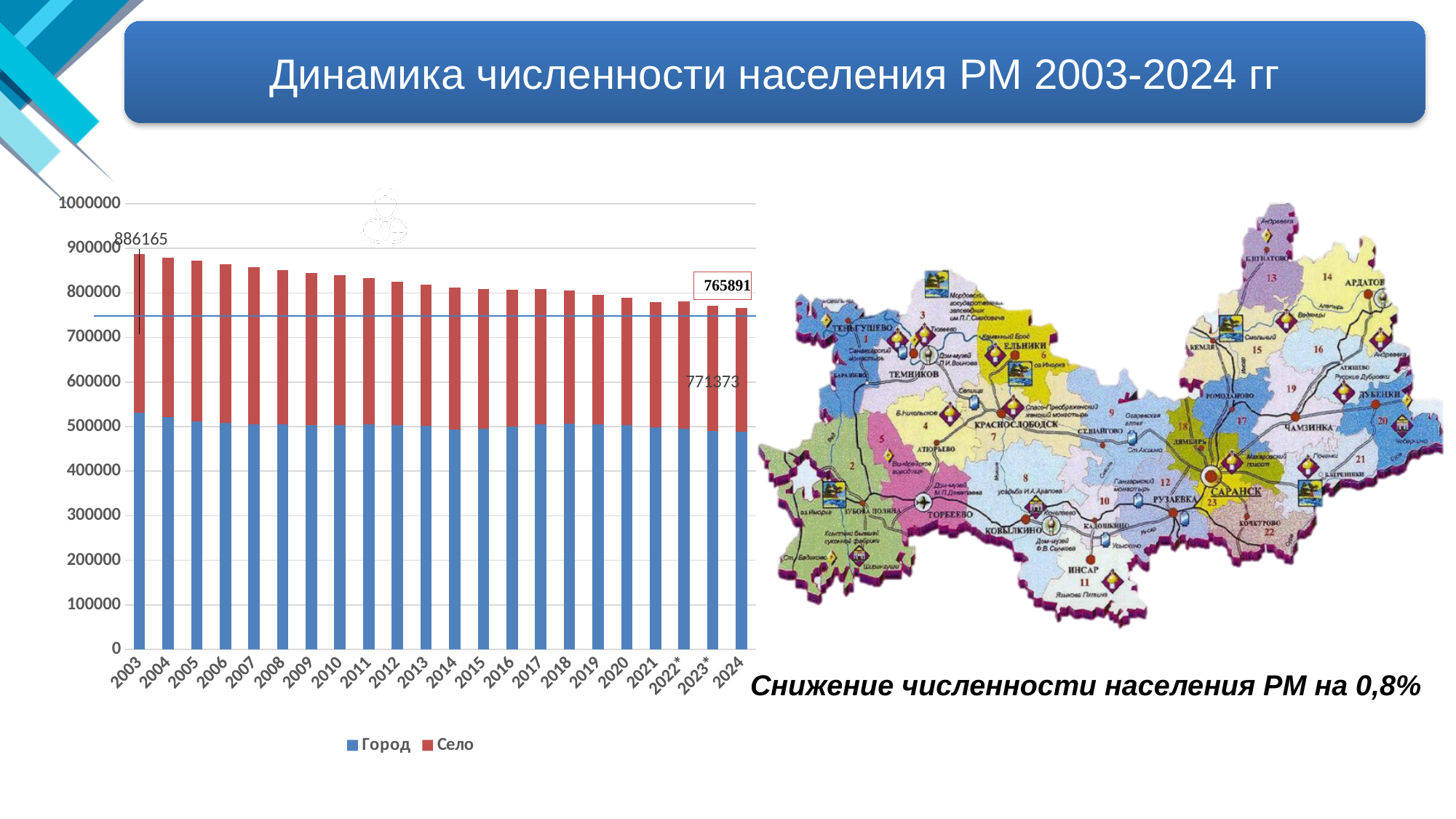
Which year has the lowest total population in the chart? 2024 What are the two series named in the chart legend? Город, Село What kind of chart is shown on the slide? bar chart How many series does the chart legend list? 2 What is the total population value labelled for 2023*? 771373 What is the difference between the labelled total for 2003 and the labelled total for 2024? 120274 What is the total population value labelled for 2003? 886165 What is the total population value labelled for 2024? 765891 How many years (categories) are shown on the x axis of the chart? 22 Which year has the highest total population in the chart? 2003 Is the total population value for 2012 greater or less than 800000? greater Do the total population values rise or fall from 2003 to 2024? fall